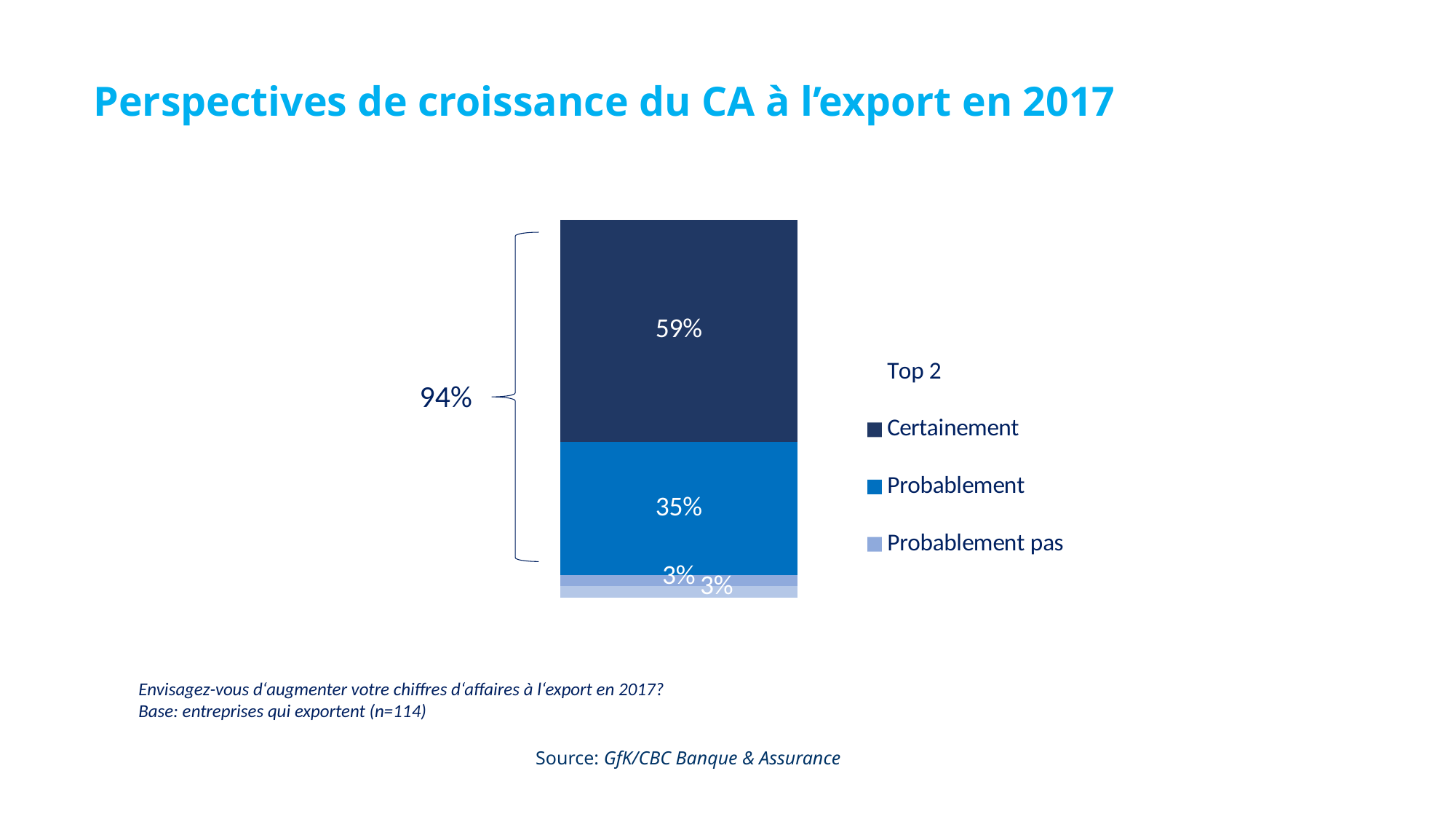
What is the base (n) of respondents stated below the chart? n=114 How many entries does the legend list? 3 Which is larger, the share for "Certainement" or the share for "Probablement"? Certainement Which response category has the largest share in the bar? Certainement What is the combined "Top 2" share shown by the bracket next to the bar? 94% What is the difference between the "Certainement" share and the "Probablement" share? 24 percentage points What percentage of exporting companies answered "Probablement pas"? 3% What kind of chart is shown on the slide? Stacked bar chart What percentage of exporting companies answered "Probablement"? 35% What is the title of the slide? Perspectives de croissance du CA à l'export en 2017 What is the sum of the "Certainement" and "Probablement" shares? 94% What percentage of exporting companies answered "Certainement"? 59%